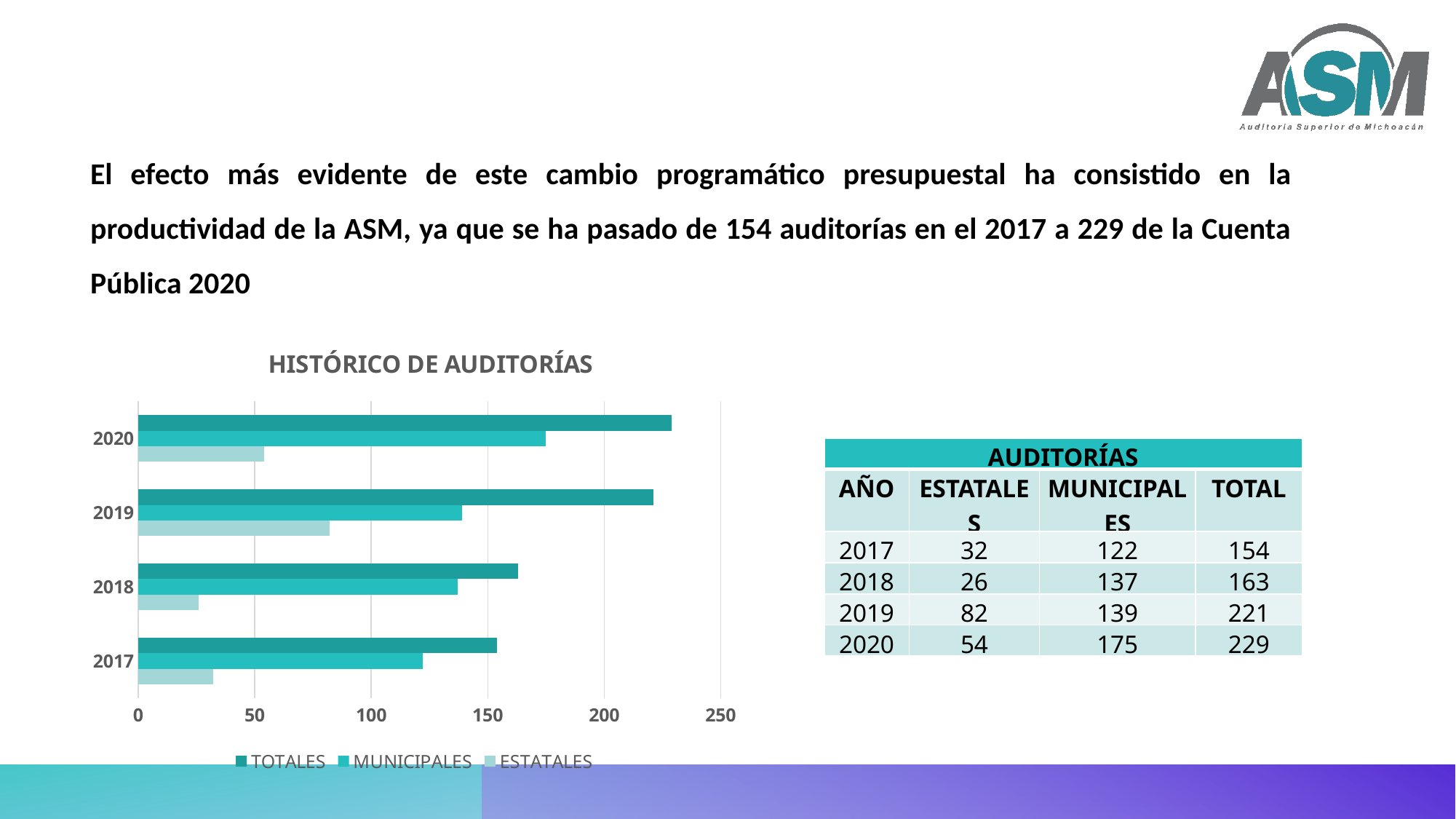
What type of chart is shown under the title HISTÓRICO DE AUDITORÍAS? bar chart What is the title of the bar chart on the slide? HISTÓRICO DE AUDITORÍAS What is the TOTAL number of auditorías for 2020 according to the slide? 229 In the HISTÓRICO DE AUDITORÍAS chart, which is larger: the MUNICIPALES value for 2020 or the MUNICIPALES value for 2017? 2020 Do the TOTALES values in the HISTÓRICO DE AUDITORÍAS chart rise or fall from 2017 to 2020? rise How many series does the legend of the HISTÓRICO DE AUDITORÍAS chart list? 3 In the HISTÓRICO DE AUDITORÍAS chart, is the ESTATALES value for 2019 greater or less than 100? less How many years are shown on the y axis of the HISTÓRICO DE AUDITORÍAS chart? 4 In the HISTÓRICO DE AUDITORÍAS chart, is the TOTALES value for 2019 greater or less than 200? greater In the HISTÓRICO DE AUDITORÍAS chart, which year has the highest TOTALES value? 2020 In the HISTÓRICO DE AUDITORÍAS chart, which year has the lowest ESTATALES value? 2018 In the HISTÓRICO DE AUDITORÍAS chart, is the MUNICIPALES value for 2020 greater or less than 150? greater